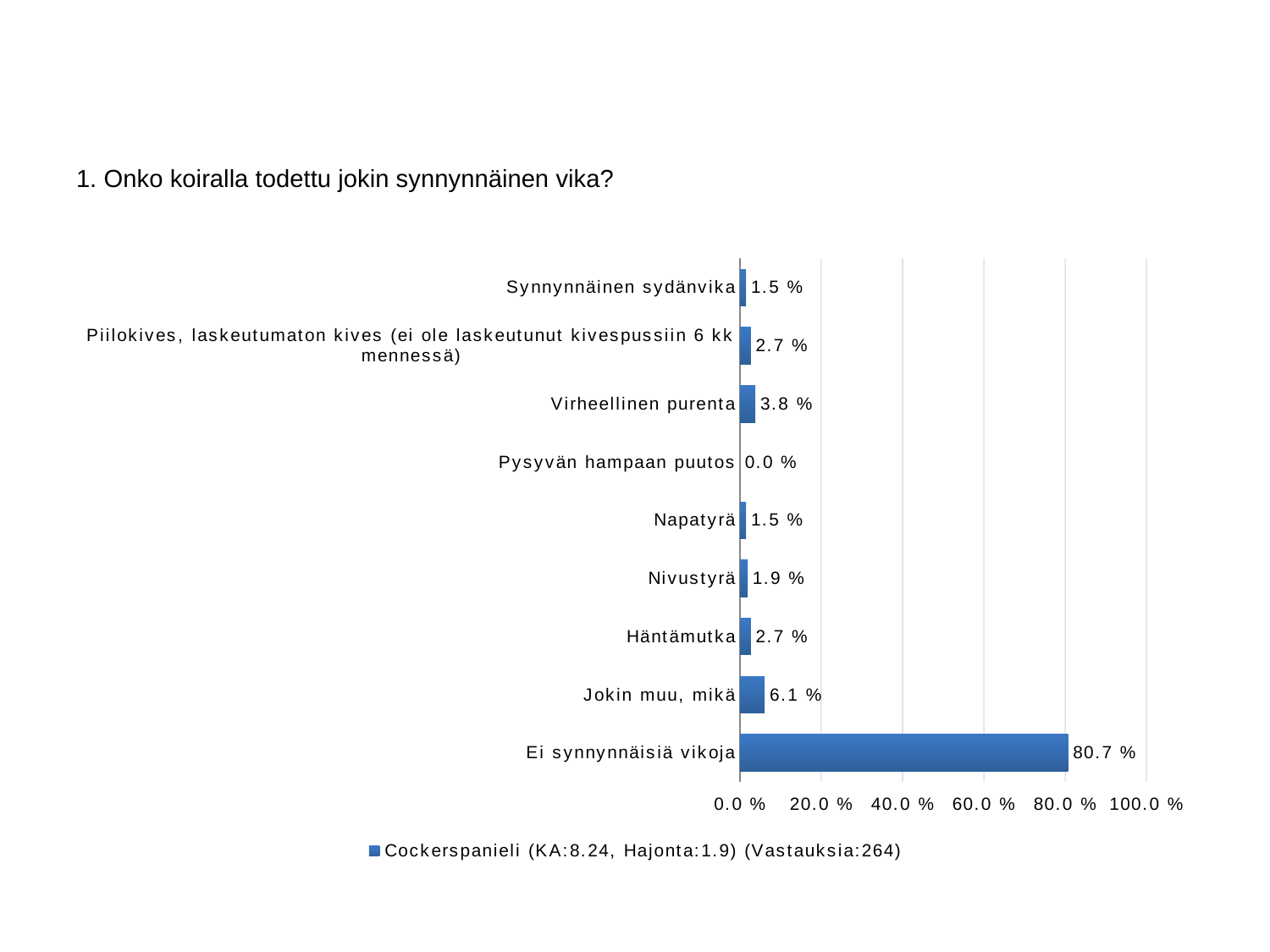
Is the value for "Ei synnynnäisiä vikoja" greater or less than 60.0 %? greater Which category has the highest value? Ei synnynnäisiä vikoja Which category has the lowest value? Pysyvän hampaan puutos What is the value for "Virheellinen purenta"? 3.8 % How many categories are shown in the chart? 9 What is the difference between the values for "Ei synnynnäisiä vikoja" and "Jokin muu, mikä"? 74.6 % What is the value for "Ei synnynnäisiä vikoja"? 80.7 % What is the value for "Jokin muu, mikä"? 6.1 % What is the value for "Nivustyrä"? 1.9 % Which is larger, the value for "Virheellinen purenta" or the value for "Häntämutka"? Virheellinen purenta How many responses (Vastauksia) does the legend entry report? 264 What kind of chart is shown on the slide? bar chart